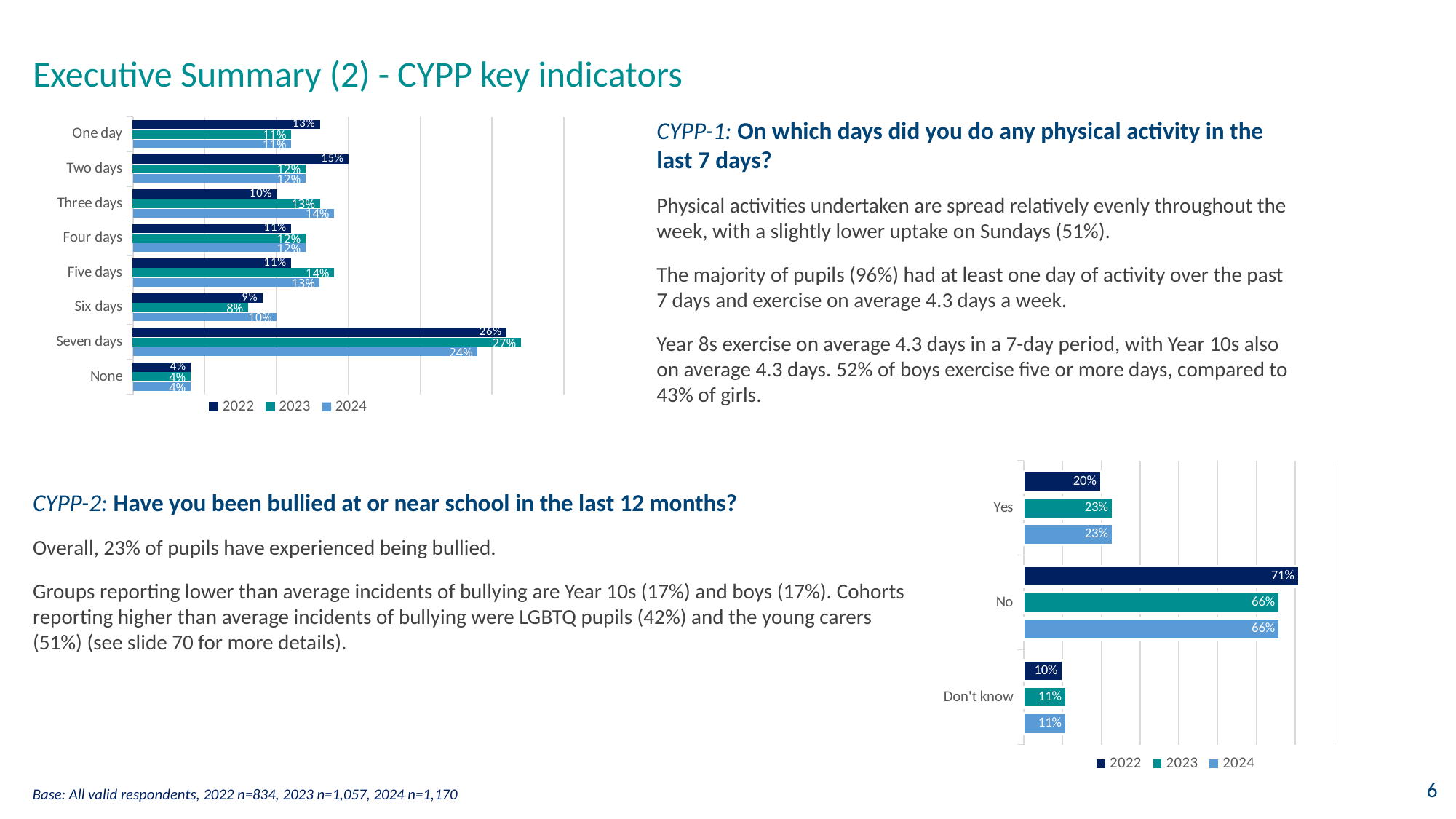
In the bar chart at the top left of the slide, what is the difference between the 2023 and 2024 values for Seven days? 3% In the bar chart at the bottom right of the slide, what is the 2022 value for No? 71% In the bar chart at the top left of the slide, how many categories are shown on the vertical axis? 8 In the bar chart at the bottom right of the slide, what is the difference between the 2022 and 2023 values for No? 5% In the bar chart at the bottom right of the slide, which is larger: the 2022 value for Yes or the 2024 value for Yes? 2024 In the bar chart at the top left of the slide, what is the 2024 value for Seven days? 24% In the bar chart at the top left of the slide, which category has the lowest 2024 value? None In the bar chart at the top left of the slide, which category has the highest 2023 value? Seven days In the bar chart at the top left of the slide, what is the 2022 value for Two days? 15% In the bar chart at the top left of the slide, how many series does the legend list? 3 In the bar chart at the bottom right of the slide, what is the 2023 value for Yes? 23% What kind of chart is shown at the bottom right of the slide? Bar chart